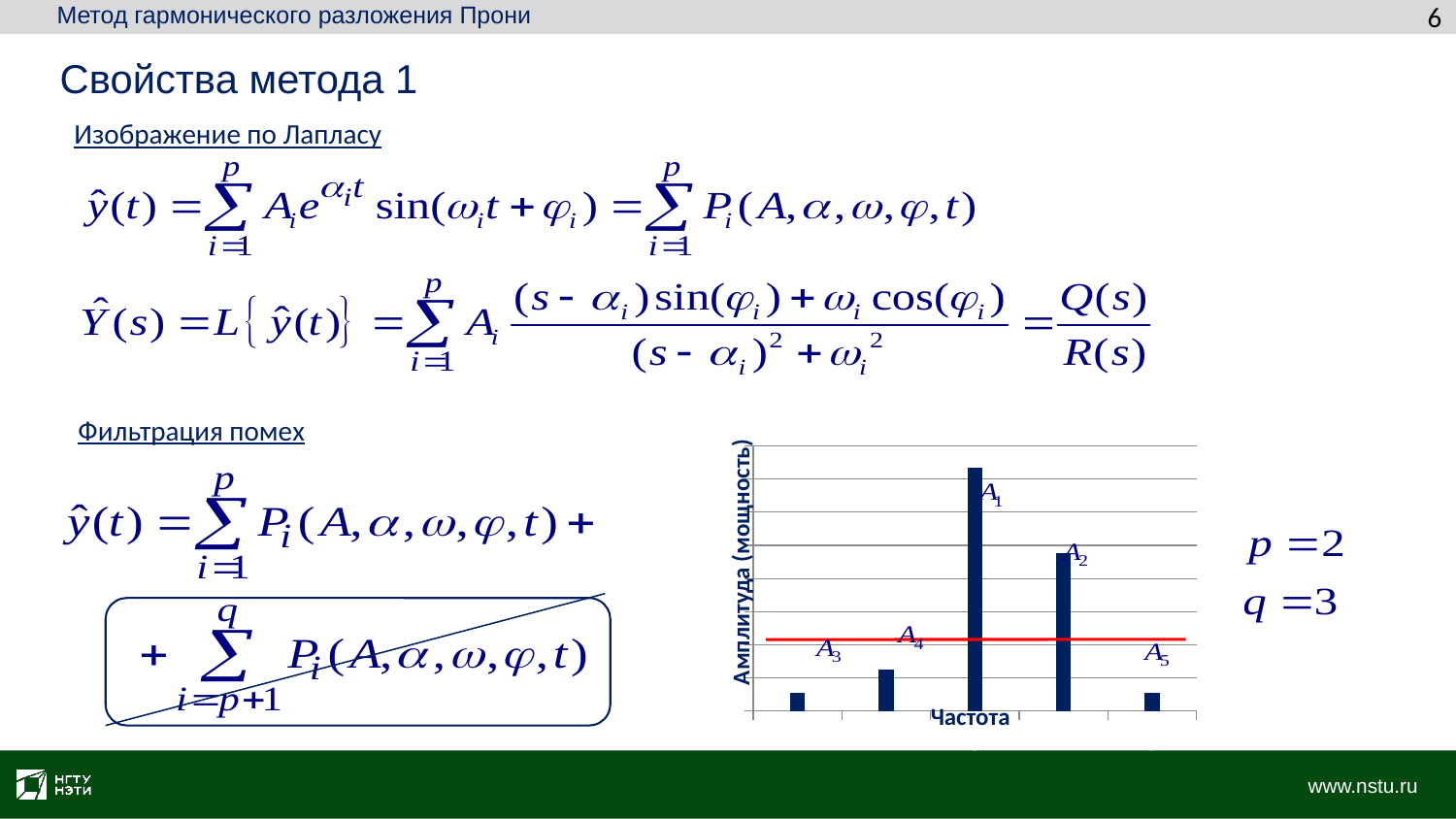
Which is larger in the chart, A1 or A2? A1 How many bars are plotted in the chart? 5 Which is larger in the chart, A4 or A3? A4 Which is larger in the chart, A4 or A2? A2 What is the title of the vertical axis of the chart? Амплитуда (мощность) What is the title of the horizontal axis of the chart? Частота Which bar in the chart is the highest? A1 What kind of chart is shown on the slide? bar chart How many bars in the chart rise above the red horizontal line? 2